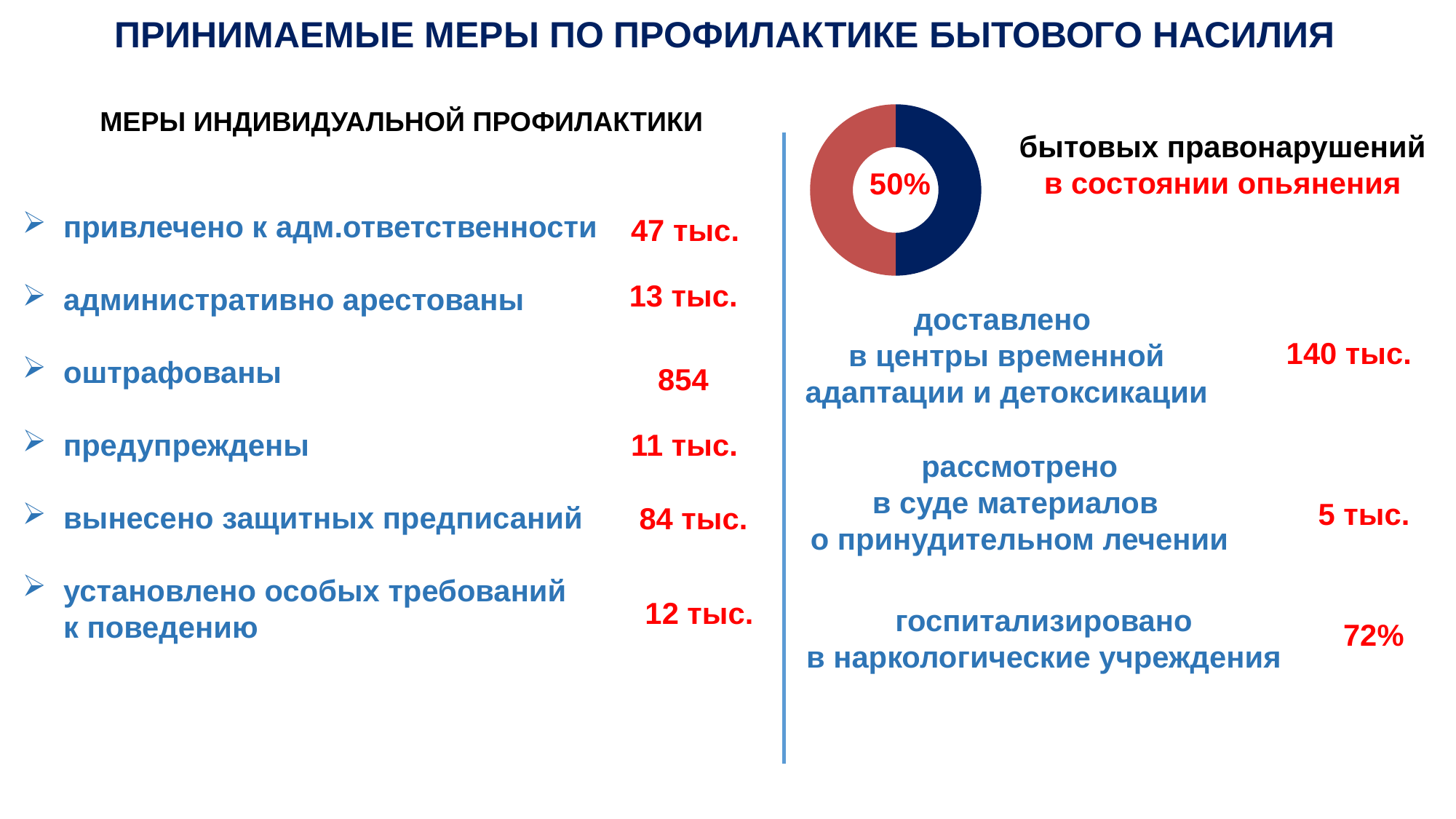
What percentage is printed in the centre of the donut chart? 50% How many slices does the donut chart have? 2 What two colours are used for the slices of the donut chart? red and dark blue Is the share shown in the donut chart greater or less than 25%? greater Does the donut chart have a legend? No What kind of chart is shown on the slide? pie chart (donut) According to the donut chart, what share of domestic offences were committed in a state of intoxication (в состоянии опьянения)? 50%